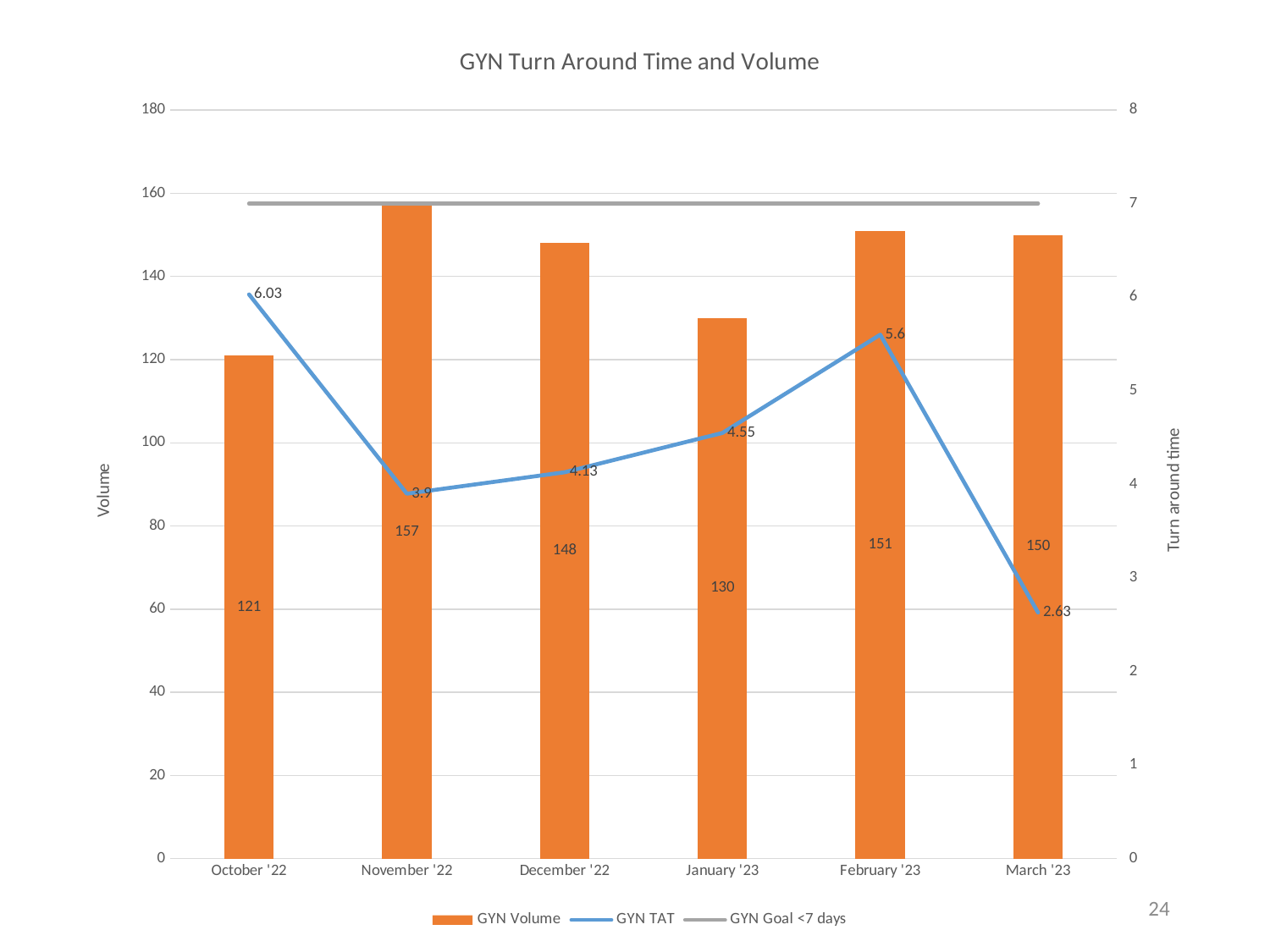
How many months are shown on the x axis? 6 Which month has the lowest GYN TAT? March '23 Is the GYN Goal line value greater or less than 6 on the Turn around time axis? greater What is the GYN TAT value for October '22? 6.03 What is the GYN Volume for November '22? 157 What is the difference in GYN Volume between November '22 and October '22? 36 What is the title of the chart? GYN Turn Around Time and Volume How many series does the legend list? 3 What is the GYN TAT value for March '23? 2.63 What kind of chart is used to show GYN Volume? bar chart Which month has the highest GYN Volume? November '22 Which is larger, the GYN Volume for February '23 or for March '23? February '23